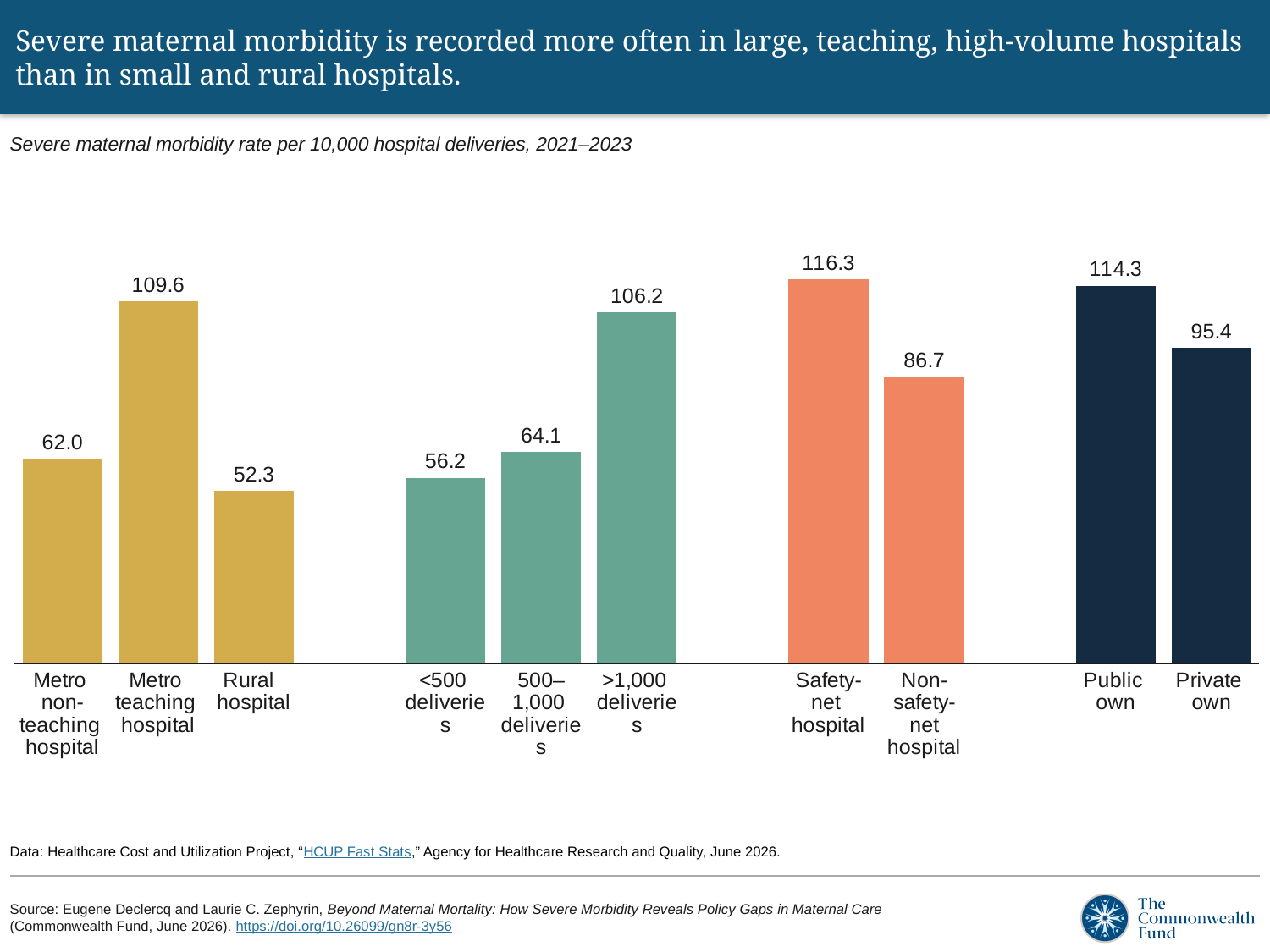
Which has a higher rate: hospitals with <500 deliveries or hospitals with 500–1,000 deliveries? 500–1,000 deliveries What is the severe maternal morbidity rate for metro teaching hospitals? 109.6 What is the value shown for hospitals with >1,000 deliveries? 106.2 Do the values rise or fall across the three delivery-volume categories from <500 to >1,000 deliveries? Rise What is the severe maternal morbidity rate for rural hospitals? 52.3 Which category has the lowest severe maternal morbidity rate? Rural hospital What is the difference between the rates for safety-net and non-safety-net hospitals? 29.6 How many categories (bars) are shown in the chart? 10 What is the difference between the rates for public own and private own hospitals? 18.9 What kind of chart is shown on the slide? Bar chart Which category has the highest severe maternal morbidity rate? Safety-net hospital What is the value shown for safety-net hospitals? 116.3